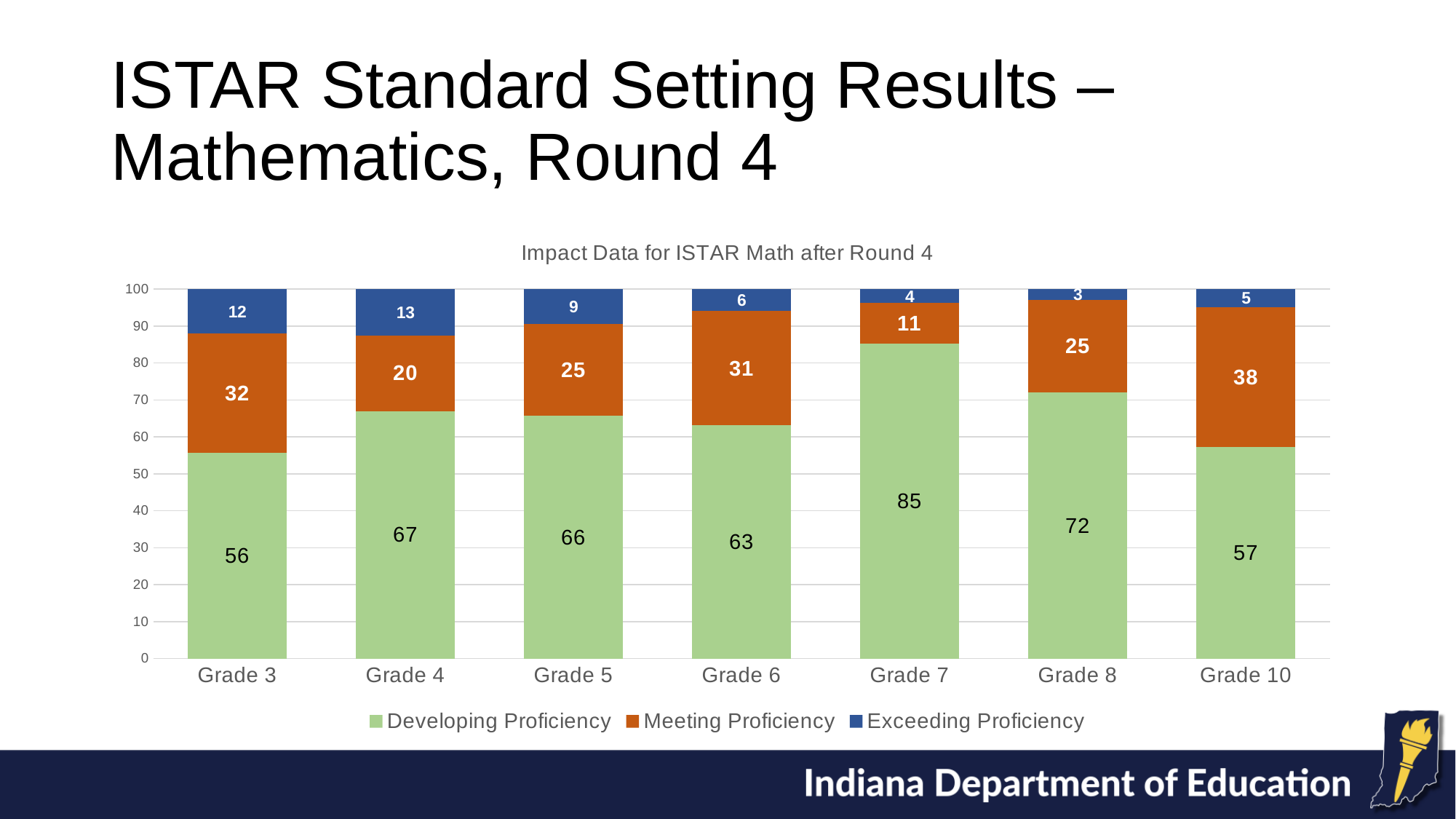
How many series does the legend list? 3 What kind of chart is shown? Stacked bar chart What is the Meeting Proficiency value for Grade 10? 38 What is the total of the stacked bar for Grade 5? 100 What is the difference between the Meeting Proficiency values for Grade 10 and Grade 7? 27 Which is larger, the Meeting Proficiency value for Grade 3 or for Grade 6? Grade 3 How many grades are shown on the x axis? 7 What is the Developing Proficiency value for Grade 7? 85 What is the title of the chart? Impact Data for ISTAR Math after Round 4 What is the Exceeding Proficiency value for Grade 4? 13 Which grade has the lowest Exceeding Proficiency value? Grade 8 Which grade has the highest Developing Proficiency value? Grade 7